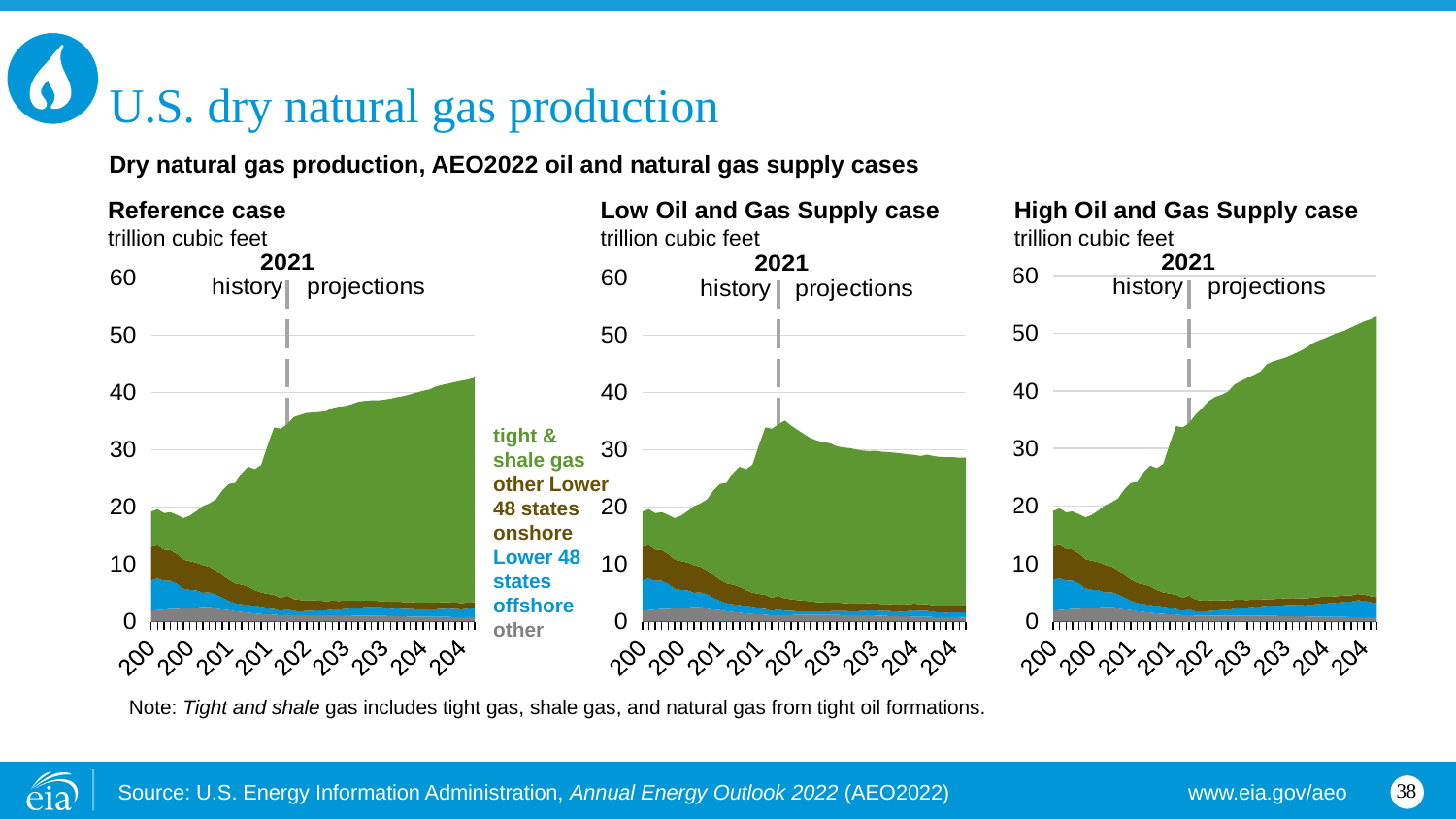
What unit is used on the y axis of the charts? trillion cubic feet What kind of chart is the Reference case chart? stacked area chart In the High Oil and Gas Supply case chart, does total production rise or fall over the projection period? rise In the Low Oil and Gas Supply case chart, is the total production at the end of the projection period greater or less than 30 trillion cubic feet? less Which year does the dashed line separating history from projections mark? 2021 How many series does the legend list for the charts? 4 In the High Oil and Gas Supply case chart, is the total production at the end of the projection period greater or less than 50 trillion cubic feet? greater Which of the three charts shows the lowest total production at the end of the projection period? Low Oil and Gas Supply case In the Low Oil and Gas Supply case chart, is the total production at its 2021 peak greater or less than 30 trillion cubic feet? greater In the Low Oil and Gas Supply case chart, does total production rise or fall after 2021? fall Which of the three charts shows the highest total production at the end of the projection period? High Oil and Gas Supply case